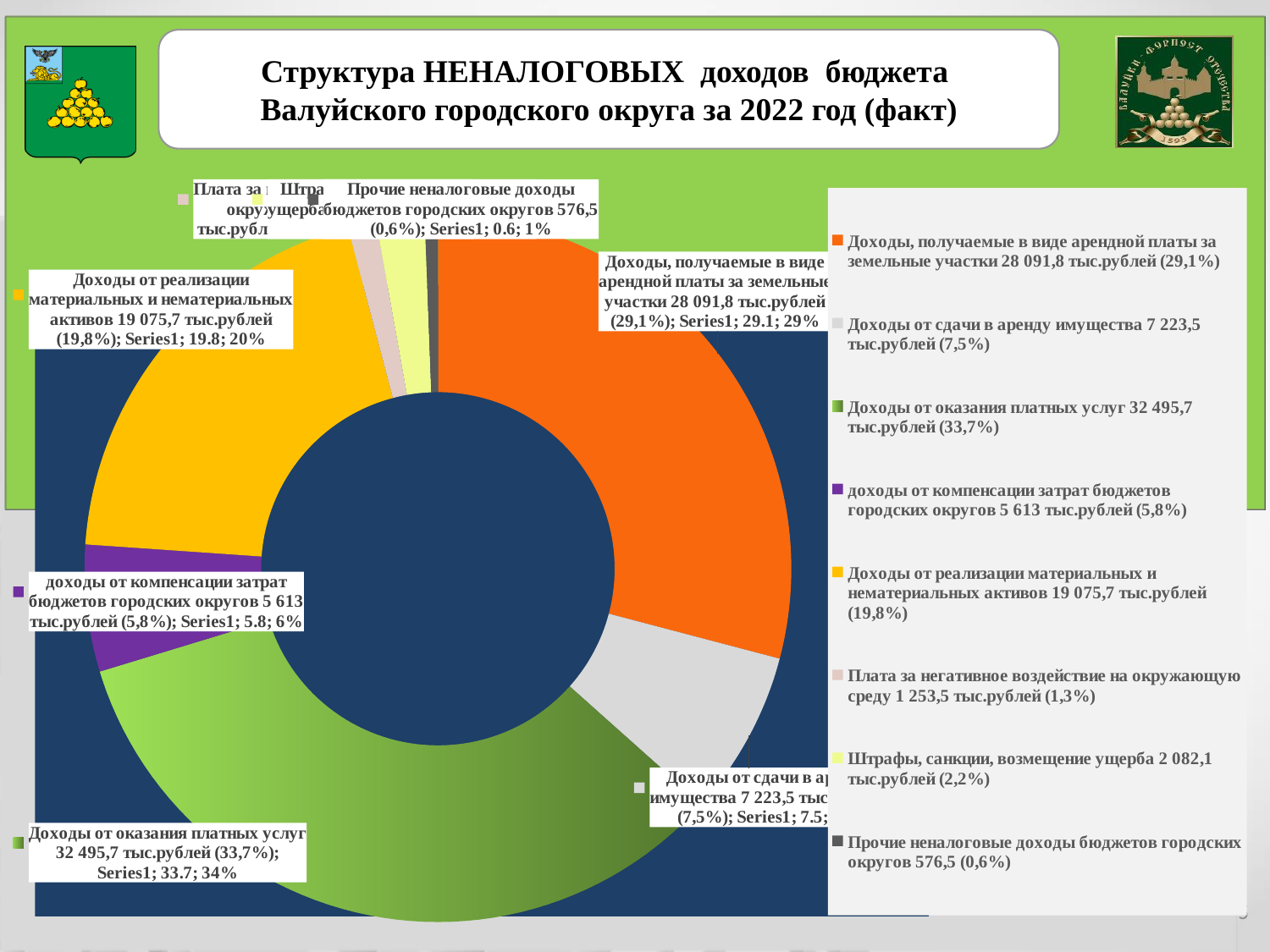
What is the difference between Доходы от оказания платных услуг and Доходы, получаемые в виде арендной платы за земельные участки? 4 403,9 тыс.рублей What percentage share does Доходы от реализации материальных и нематериальных активов have? 19,8% What is the value for Штрафы, санкции, возмещение ущерба? 2 082,1 тыс.рублей How many categories does the chart's legend list? 8 What is the title of the chart on the slide? Структура НЕНАЛОГОВЫХ доходов бюджета Валуйского городского округа за 2022 год (факт) What percentage share does Доходы от оказания платных услуг have? 33,7% Which category has the smallest share of non-tax revenues? Прочие неналоговые доходы бюджетов городских округов What is the value for Доходы, получаемые в виде арендной платы за земельные участки? 28 091,8 тыс.рублей What kind of chart is shown on the slide? Doughnut (pie) chart What is the value for Доходы от сдачи в аренду имущества? 7 223,5 тыс.рублей Which category has the largest share of non-tax revenues? Доходы от оказания платных услуг Which is larger: доходы от компенсации затрат бюджетов городских округов or Плата за негативное воздействие на окружающую среду? доходы от компенсации затрат бюджетов городских округов